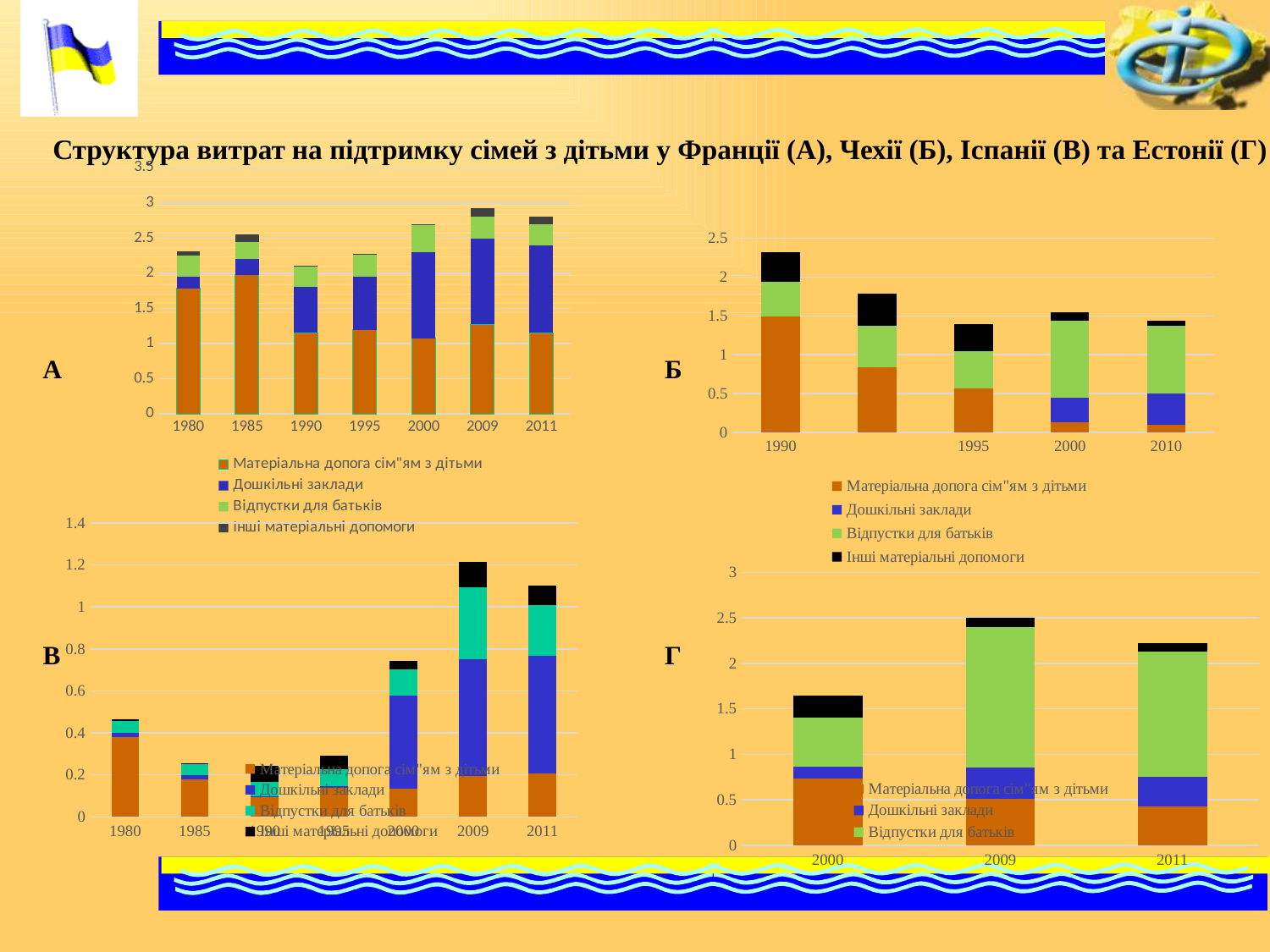
In chart В, which year has the highest total bar? 2009 In chart Б, is the total for 2000 greater or less than 2? less What kind of chart is chart А? bar chart In chart А, which year has the highest total bar? 2009 In chart Б, which year has the highest total bar? 1990 In chart Г, how many years are shown on the x axis? 3 In chart А, is the total for 1980 greater or less than 2? greater In chart А, how many years are shown on the x axis? 7 In chart А, how many series does the legend list? 4 In chart В, is the total for 1980 greater or less than 0.6? less In chart Г, which year has the lowest total bar? 2000 In chart Б, how many years are shown on the x axis? 4